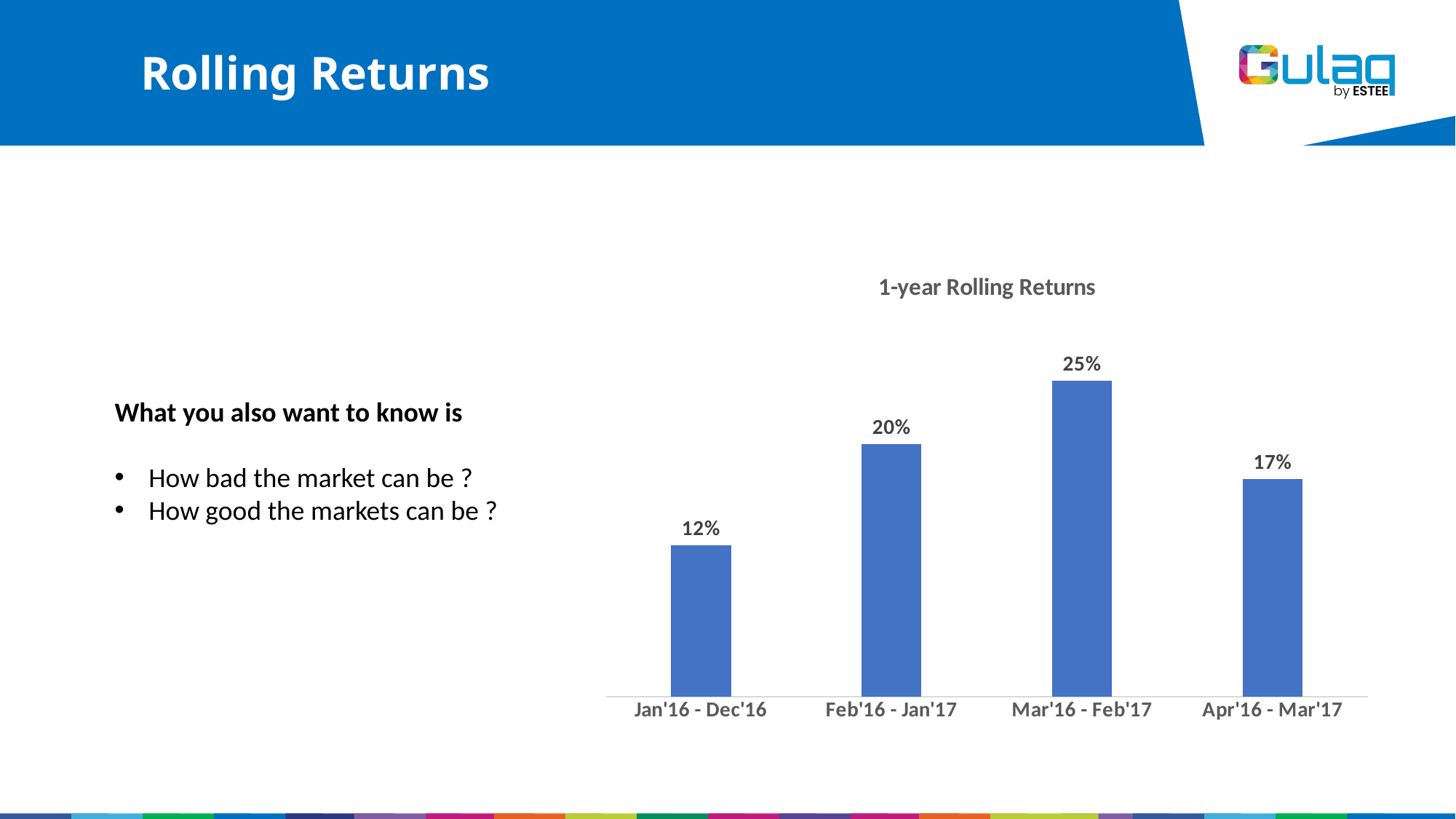
What is the title of the chart? 1-year Rolling Returns What is the 1-year rolling return for Apr'16 - Mar'17? 17% What kind of chart is shown on the slide? Bar chart What is the difference between the rolling returns for Feb'16 - Jan'17 and Apr'16 - Mar'17? 3% What is the difference between the rolling returns for Mar'16 - Feb'17 and Jan'16 - Dec'16? 13% Which period has the highest 1-year rolling return? Mar'16 - Feb'17 What is the 1-year rolling return for Feb'16 - Jan'17? 20% Which period has the lowest 1-year rolling return? Jan'16 - Dec'16 How many periods are shown in the chart? 4 Which is larger, the rolling return for Feb'16 - Jan'17 or for Apr'16 - Mar'17? Feb'16 - Jan'17 What is the 1-year rolling return for Jan'16 - Dec'16? 12% What is the 1-year rolling return for Mar'16 - Feb'17? 25%